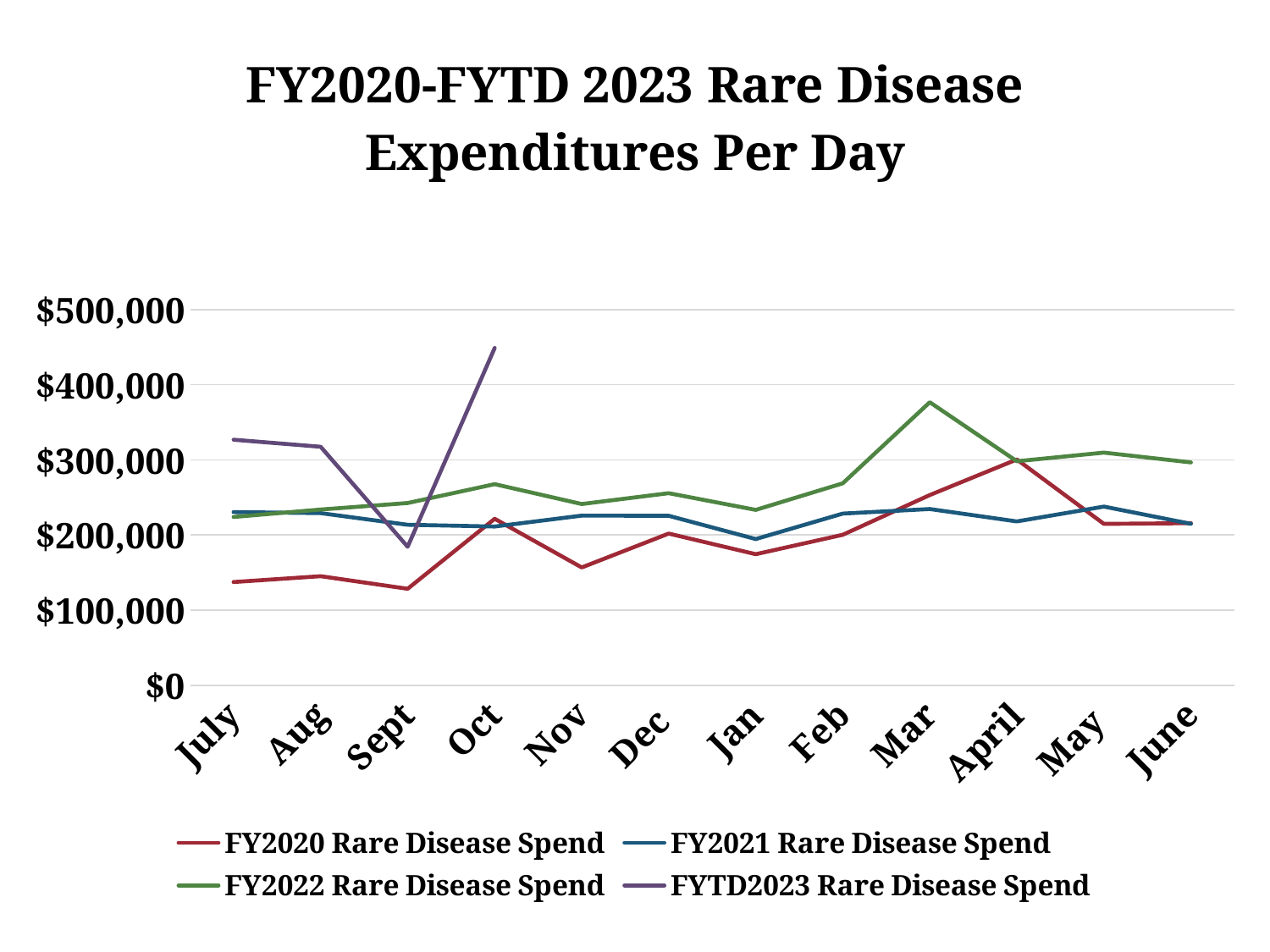
In which month does the FY2020 Rare Disease Spend line reach its highest value? April Is the FY2022 Rare Disease Spend value for Mar greater or less than $300,000? greater For how many months does the FYTD2023 Rare Disease Spend line have data points? 4 Is the FY2020 Rare Disease Spend value for Sept greater or less than $200,000? less In which month does the FY2022 Rare Disease Spend line reach its highest value? Mar In Mar, which is larger: FY2022 Rare Disease Spend or FY2020 Rare Disease Spend? FY2022 Rare Disease Spend How many series does the legend list? 4 What kind of chart is shown on the slide? Line chart Is the FYTD2023 Rare Disease Spend value for Oct greater or less than $400,000? greater Which series has the highest value in Oct? FYTD2023 Rare Disease Spend Which series has the lowest value in July? FY2020 Rare Disease Spend How many months are shown along the x axis? 12